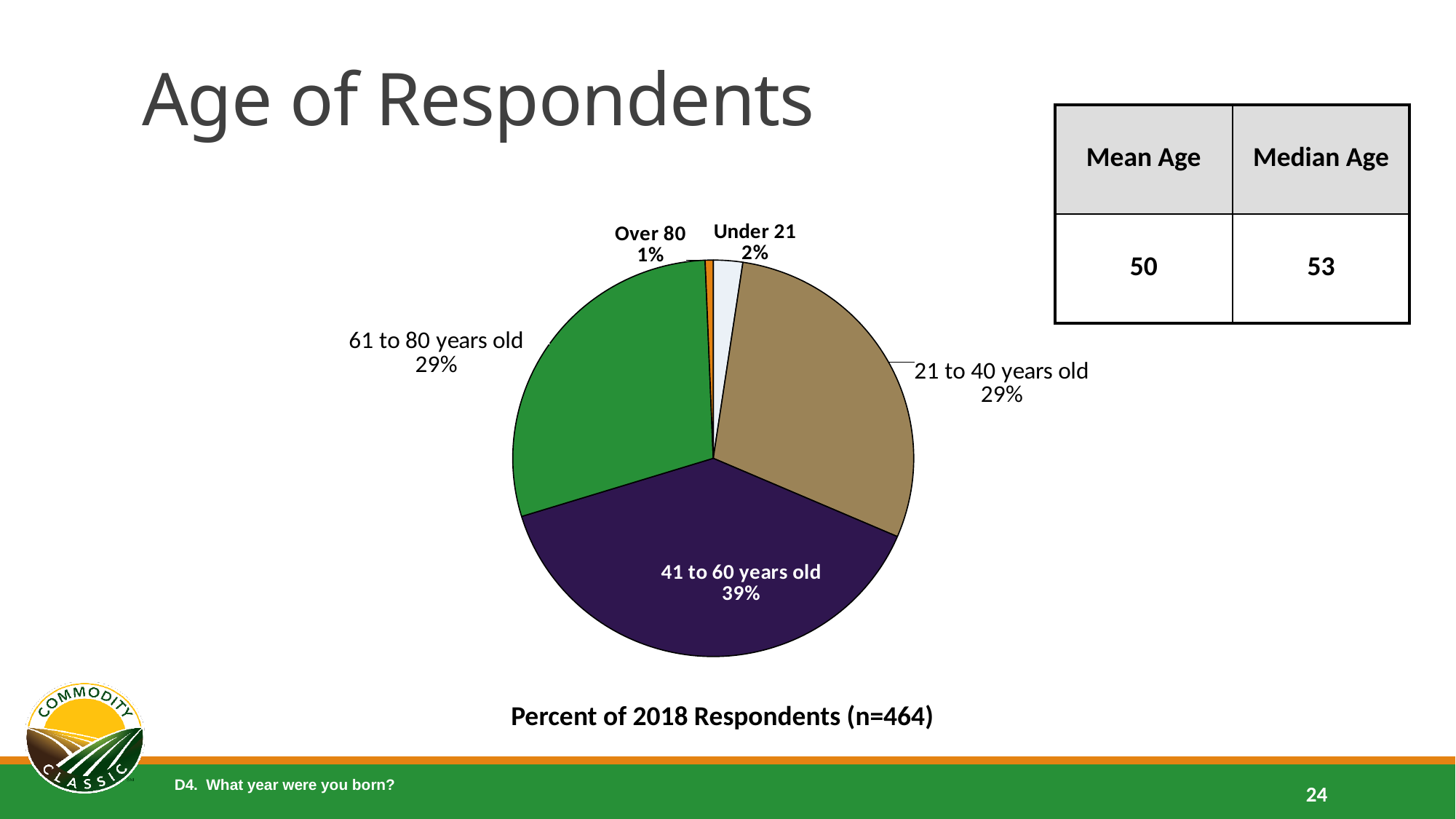
What percentage of respondents are Under 21? 2% What percentage of respondents are 41 to 60 years old? 39% What percentage of respondents are Over 80? 1% What is the caption below the pie chart? Percent of 2018 Respondents (n=464) Which age group has the smallest share of respondents? Over 80 How many age groups are shown in the pie chart? 5 What is the combined share of the 21 to 40 years old and 61 to 80 years old groups? 58% Which is larger: the share of respondents Under 21 or the share Over 80? Under 21 Which age group has the largest share of respondents? 41 to 60 years old What percentage of respondents are 21 to 40 years old? 29% What kind of chart is shown on the slide? Pie chart What is the difference in percentage points between the 41 to 60 years old group and the 61 to 80 years old group? 10